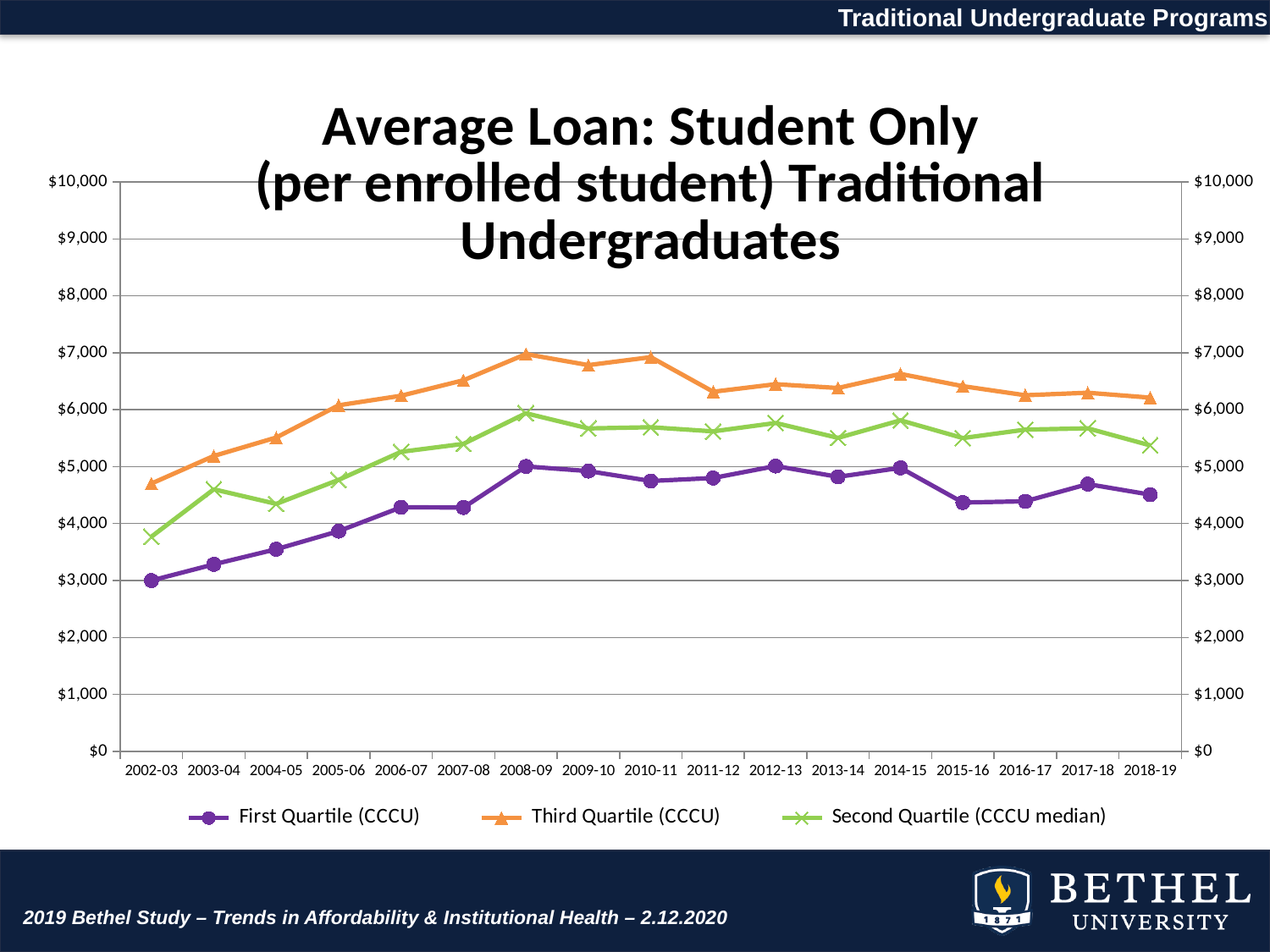
What kind of chart is shown on the slide? line chart Which is larger for First Quartile (CCCU): the value in 2008-09 or the value in 2015-16? 2008-09 How many series does the legend list? 3 Do the First Quartile (CCCU) values rise or fall from 2002-03 to 2008-09? rise What marker shape is used for the Third Quartile (CCCU) series? triangle Is the value for Third Quartile (CCCU) in 2004-05 greater or less than $6,000? less Is the value for First Quartile (CCCU) in 2002-03 greater or less than $4,000? less Which year has the lowest value for First Quartile (CCCU)? 2002-03 How many academic years are plotted along the x axis? 17 Is the value for Third Quartile (CCCU) in 2008-09 greater or less than $6,000? greater Which year has the lowest value for Third Quartile (CCCU)? 2002-03